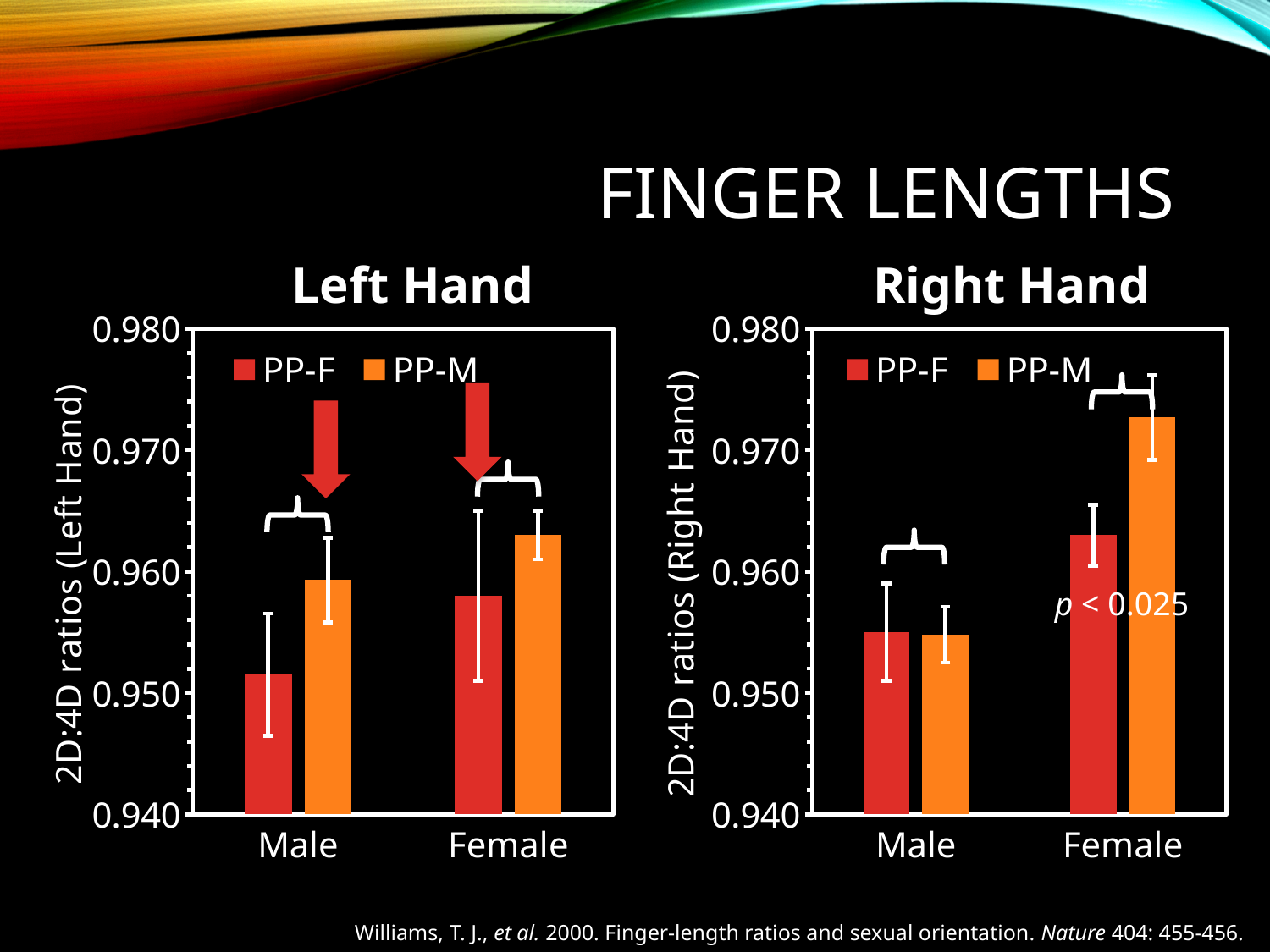
In the Left Hand chart, is the PP-M value for Female greater or less than 0.960? greater In the Left Hand chart, which is larger for Male: PP-F or PP-M? PP-M How many series does the legend of the Right Hand chart list? 2 In the Left Hand chart, which bar is the lowest? Male PP-F In the Right Hand chart, which is larger for Female: PP-F or PP-M? PP-M In the Right Hand chart, is the PP-M value for Female greater or less than 0.970? greater In the Left Hand chart, is the PP-F value for Male greater or less than 0.960? less In the Right Hand chart, which bar is the highest? Female PP-M How many categories are shown on the x axis of the Left Hand chart? 2 What kind of chart is the Left Hand chart? bar chart What is the y-axis title of the Right Hand chart? 2D:4D ratios (Right Hand)